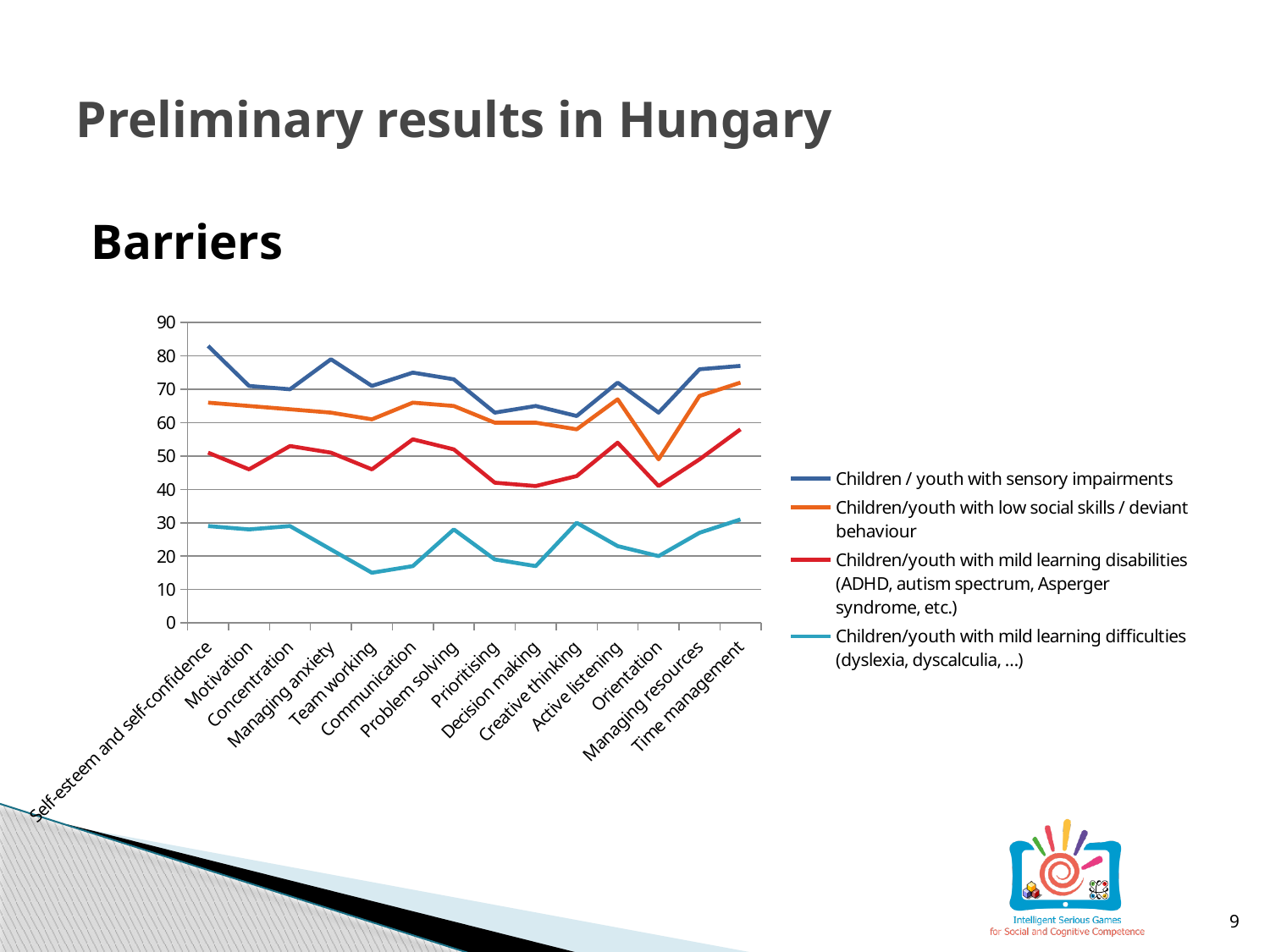
How many categories are shown along the x axis? 14 For which category is the Children / youth with sensory impairments series highest? Self-esteem and self-confidence Does the Children / youth with sensory impairments series rise or fall from Orientation to Time management? Rise Is the value for Team working in the Children/youth with mild learning difficulties series greater or less than 20? less How many series does the legend list? 4 Is the value for Communication in the Children/youth with mild learning disabilities series greater or less than 50? greater What kind of chart is shown on the slide? Line chart For which category is the Children/youth with low social skills / deviant behaviour series lowest? Orientation Is the value for Managing resources in the Children/youth with low social skills / deviant behaviour series greater or less than 60? greater At Orientation, which series has the higher value: Children / youth with sensory impairments or Children/youth with low social skills / deviant behaviour? Children / youth with sensory impairments Which series is drawn in orange? Children/youth with low social skills / deviant behaviour